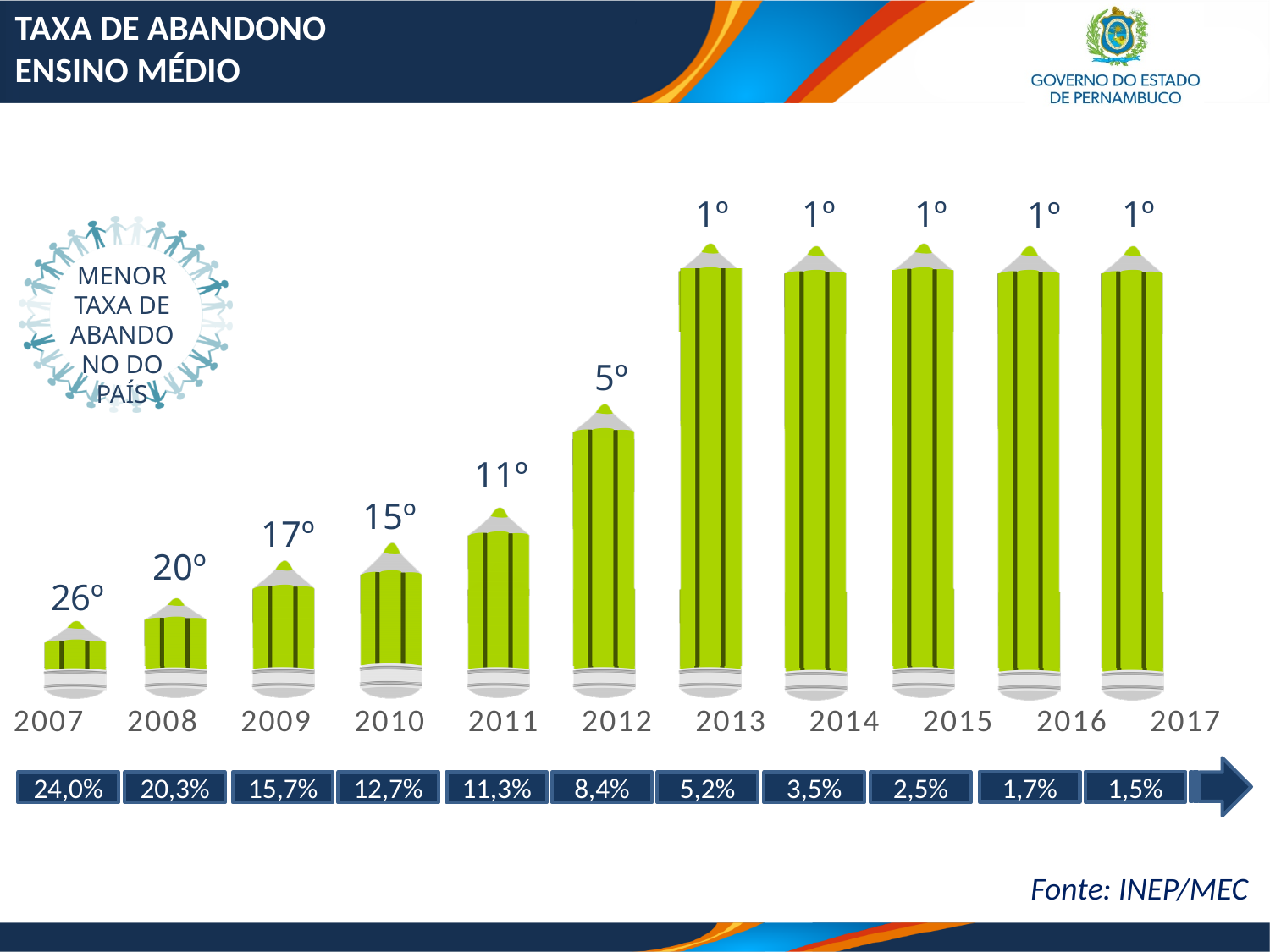
What ranking position is shown for 2007? 26º What kind of chart is shown on the slide? Bar chart What is the abandonment rate (taxa de abandono) shown for 2009? 15,7% In how many years does the chart show a ranking of 1º? 5 Which year has a higher abandonment rate, 2011 or 2013? 2011 Do the abandonment rates rise or fall from 2007 to 2017? Fall What is the abandonment rate shown for 2017? 1,5% What ranking position is shown for 2012? 5º Which year has the highest abandonment rate shown on the slide? 2007 Which year has the lowest abandonment rate shown on the slide? 2017 How many years are shown on the x axis of the chart? 11 What is the difference between the abandonment rates for 2007 and 2008? 3,7%